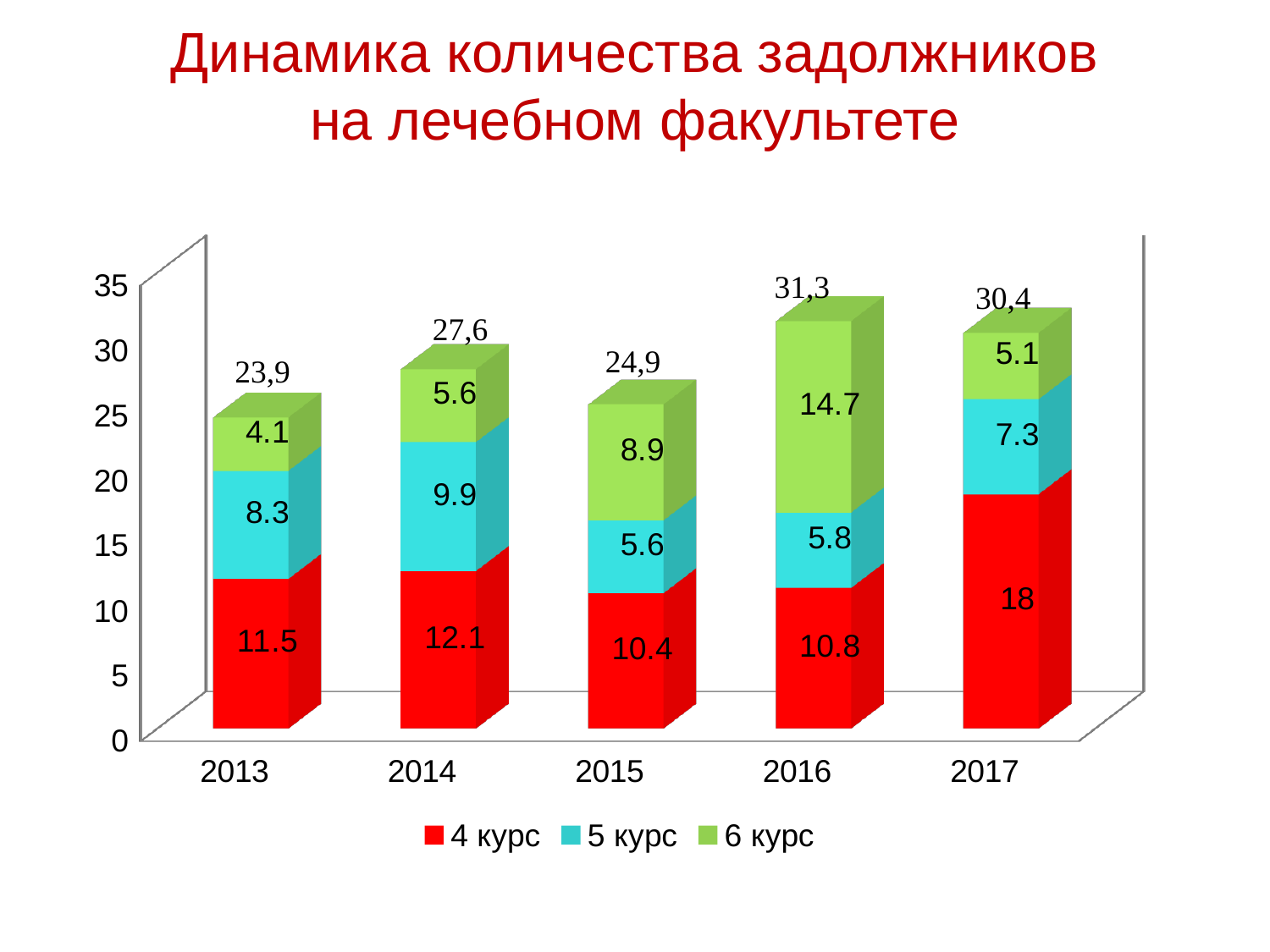
What is the value for 6 курс in 2016? 14.7 Which year has the lowest value for 6 курс? 2013 How many years are shown on the x axis? 5 What is the value for 4 курс in 2017? 18 What is the total shown above the stacked bar for 2016? 31,3 What is the total shown above the stacked bar for 2013? 23,9 What kind of chart is shown on the slide? stacked bar chart How many series does the legend list? 3 Which year has the highest value for 4 курс? 2017 Which is larger, the 5 курс value in 2013 or in 2016? 2013 What is the difference between the 4 курс values for 2017 and 2015? 7.6 What is the value for 5 курс in 2014? 9.9